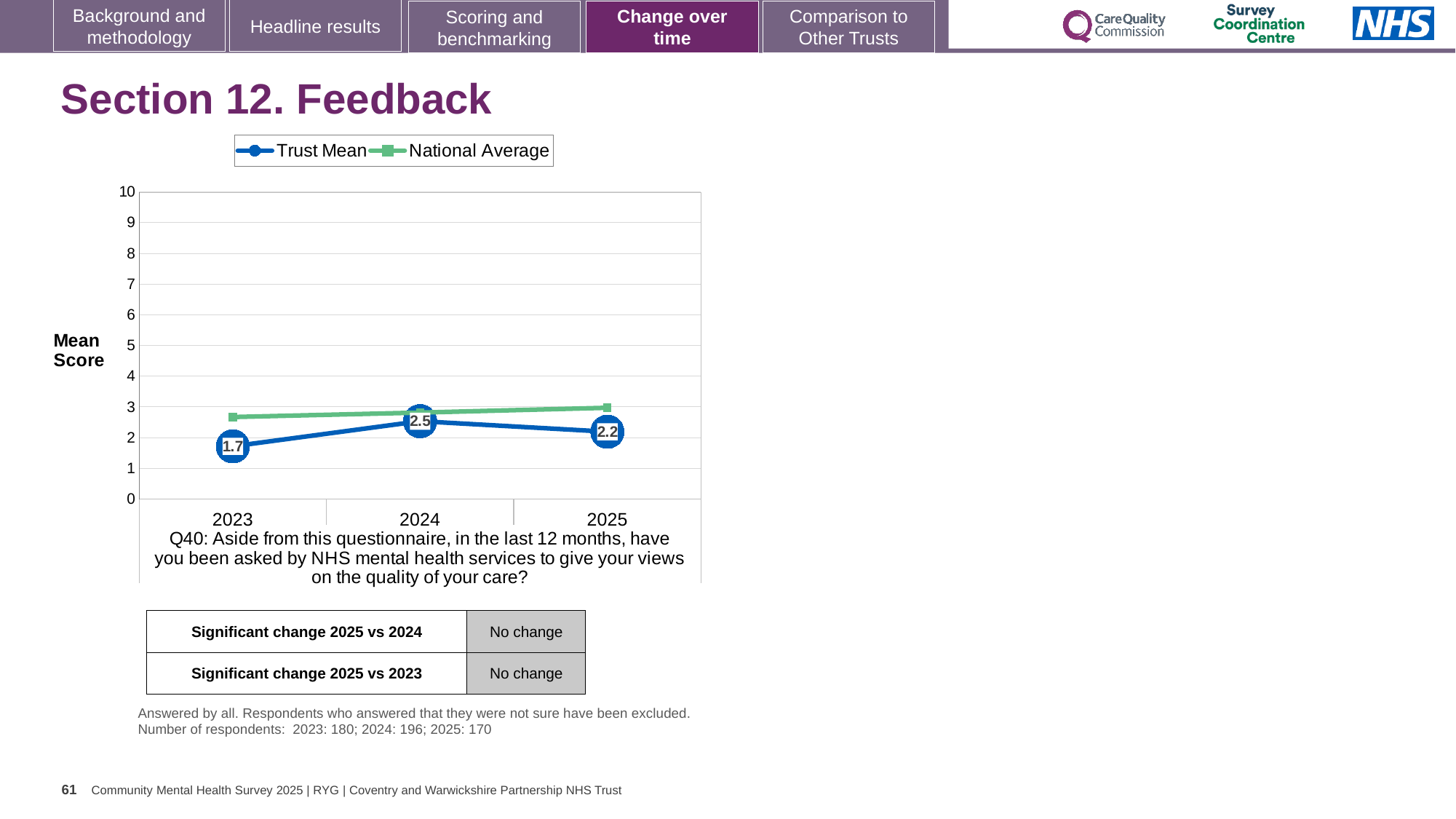
In which year is the Trust Mean lowest? 2023 What is the Trust Mean score for 2024? 2.5 How many years are plotted on the x axis? 3 What kind of chart is shown on the slide? Line chart What is the difference between the Trust Mean in 2024 and in 2023? 0.8 How many series does the legend list? 2 Does the Trust Mean rise or fall from 2024 to 2025? Fall What is the Trust Mean score for 2023? 1.7 In which year is the Trust Mean highest? 2024 Is the National Average value for 2025 greater or less than 5? less What is the Trust Mean score for 2025? 2.2 Which is larger, the Trust Mean in 2023 or in 2025? 2025